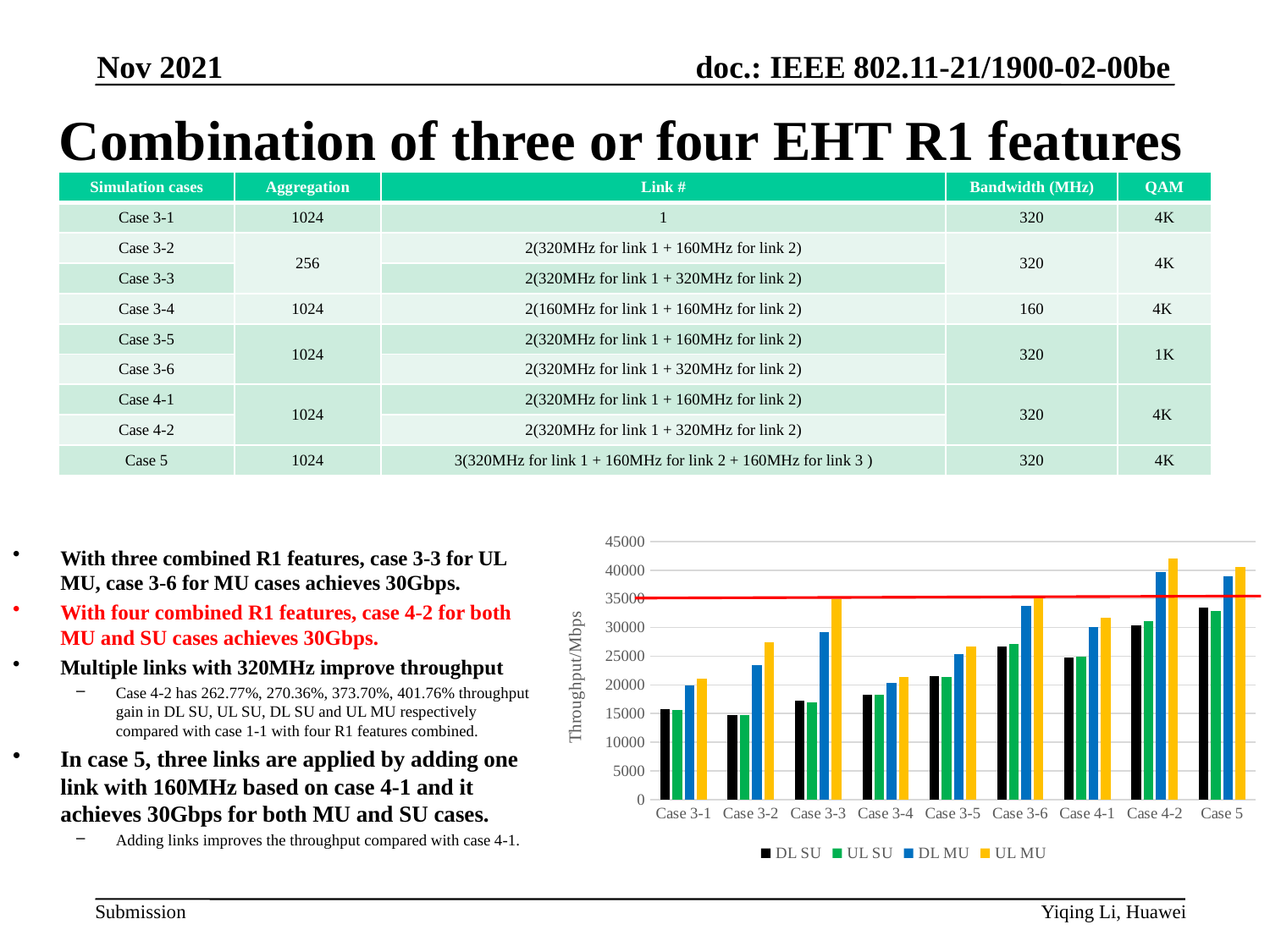
In Case 3-3, which is larger, the UL MU value or the DL SU value? UL MU Is the DL SU value for Case 3-1 greater or less than 20000? less How many simulation cases are shown on the x axis of the chart? 9 Is the DL SU value for Case 5 greater or less than 30000? greater What is the label of the y axis of the chart? Throughput/Mbps Which is larger, the DL MU value for Case 4-2 or the DL MU value for Case 3-1? Case 4-2 Is the UL MU value for Case 4-2 greater or less than 40000? greater Which case has the highest UL MU throughput in the chart? Case 4-2 How many series does the chart legend list? 4 What kind of chart is shown on the slide? bar chart Which series is drawn in yellow in the chart? UL MU